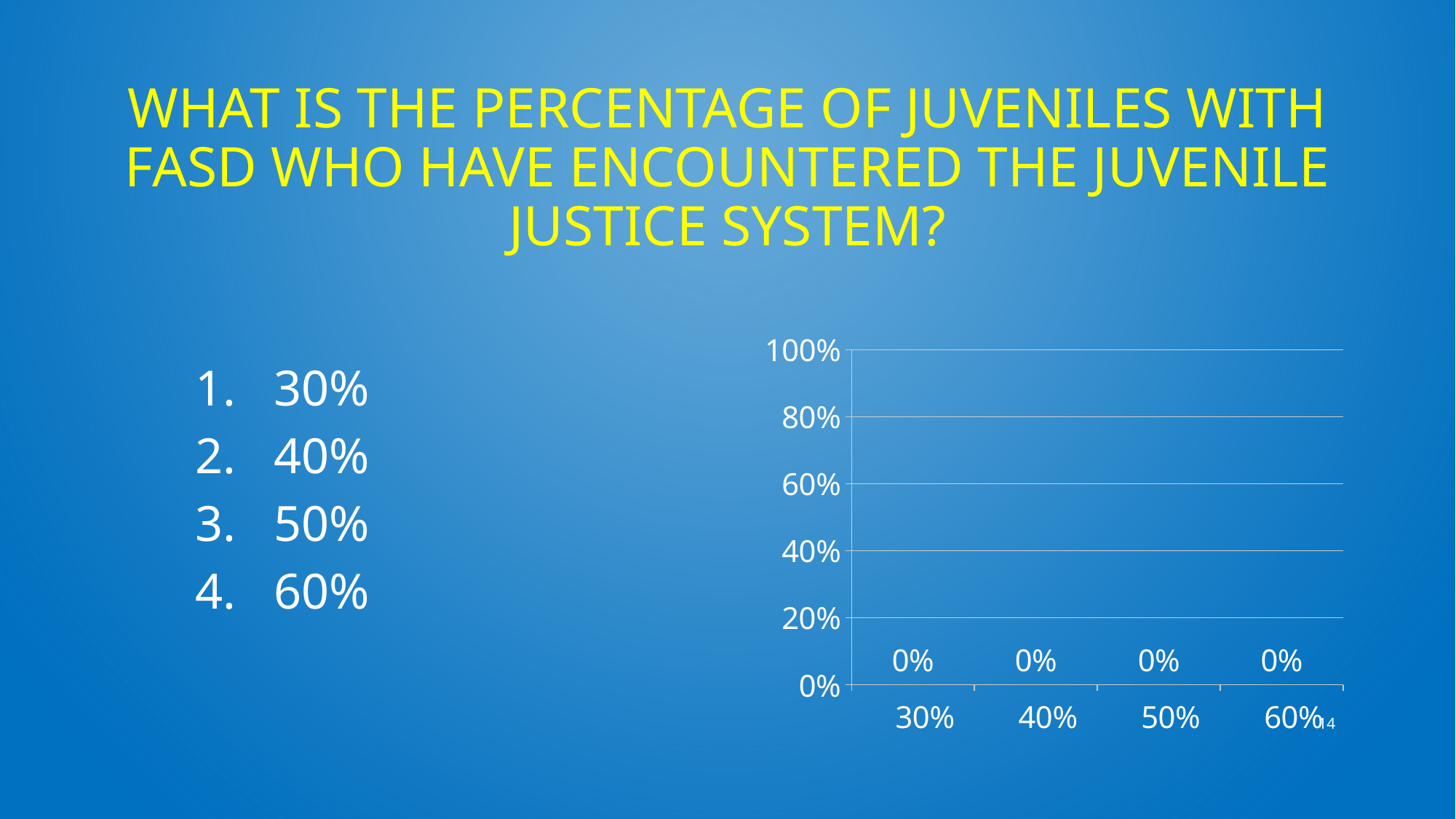
What is the label of the first category on the x axis of the chart? 30% What is the value shown for the category "30%" in the chart? 0% Is the value for the category "40%" greater or less than 20%? less Do the values rise, fall, or stay flat across the categories from "30%" to "60%"? stay flat How many categories are shown on the x axis of the chart? 4 What is the highest tick label on the vertical axis of the chart? 100% What is the difference between the values for the categories "30%" and "40%"? 0% What kind of chart is shown on the slide? bar chart What is the value shown for the category "50%" in the chart? 0% What is the value shown for the category "60%" in the chart? 0%